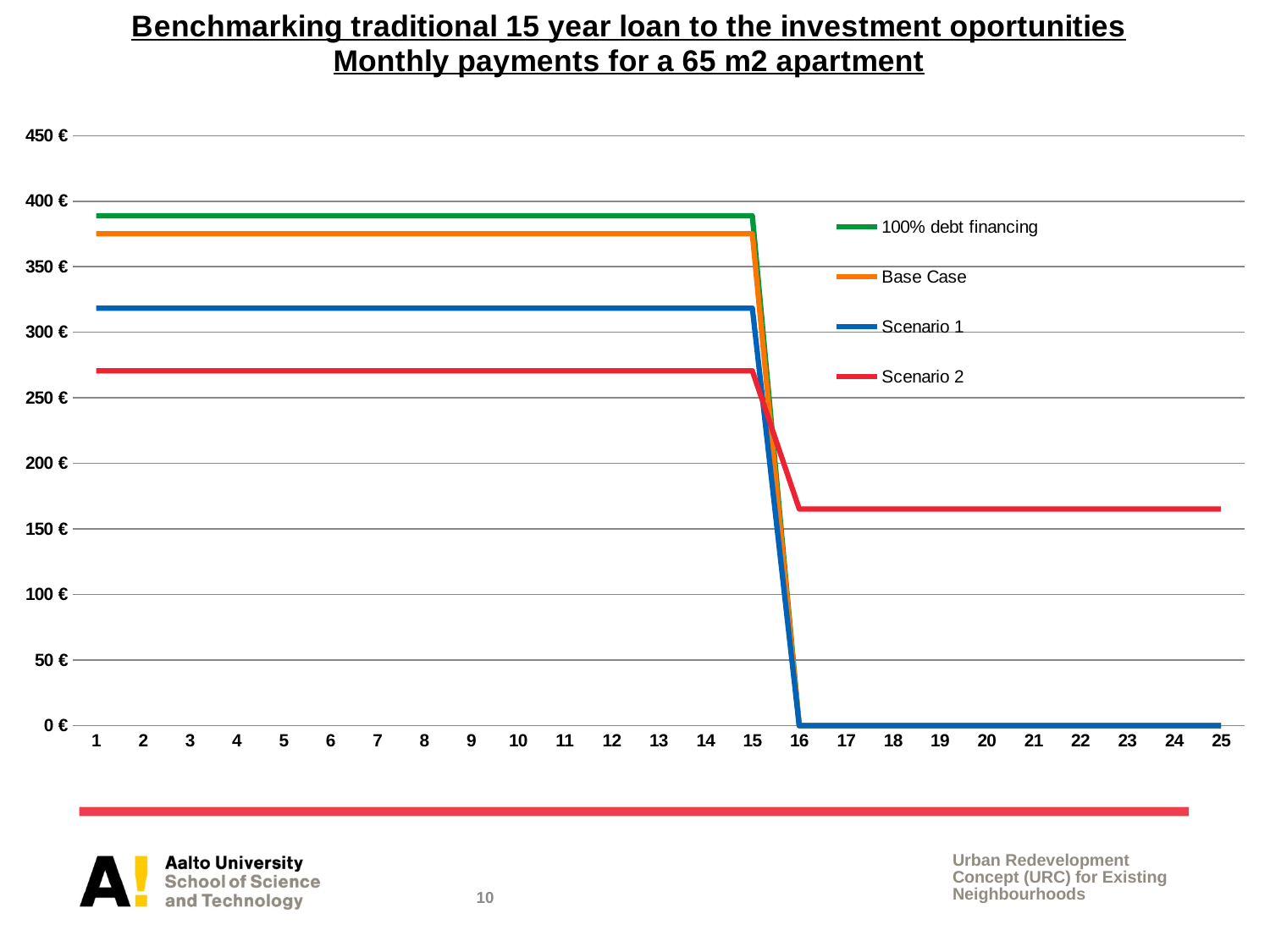
At year 20, which is larger: Scenario 2 or Scenario 1? Scenario 2 Is the value for Scenario 1 at year 10 greater or less than 300 €? greater Does the Scenario 2 line rise or fall between year 15 and year 16? fall Is the value for 100% debt financing at year 3 greater or less than 400 €? less At year 10, which is larger: Base Case or Scenario 1? Base Case How many points are shown along the x axis? 25 Which series has the highest value at year 5? 100% debt financing Which series has the lowest value at year 5? Scenario 2 What kind of chart is shown on the slide? line chart Is the value for Scenario 1 at year 20 greater or less than 50 €? less How many series does the legend list? 4